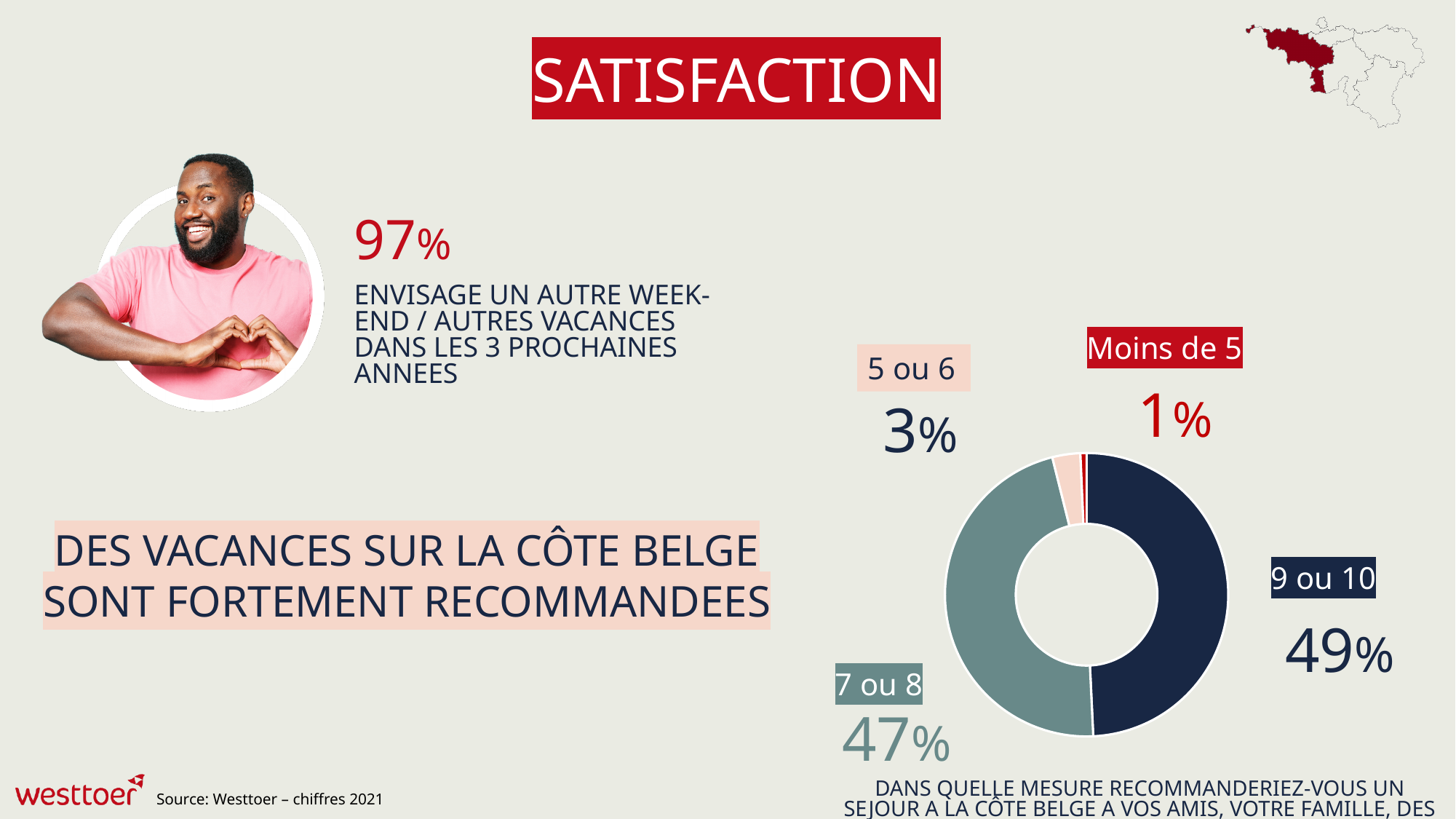
What percentage of respondents gave a score of 7 ou 8? 47% What percentage of respondents gave a score of 9 ou 10? 49% What percentage of respondents gave a score of 5 ou 6? 3% What percentage of respondents gave a score of Moins de 5? 1% Which is larger, the share for 7 ou 8 or the share for 5 ou 6? 7 ou 8 How many categories does the donut chart show? 4 How many percentage points separate the 9 ou 10 and 7 ou 8 categories? 2 Which category has the largest share of the donut chart? 9 ou 10 Which category has the smallest share of the donut chart? Moins de 5 What kind of chart is shown on the right of the slide? donut (pie) chart What is the combined share of the 9 ou 10 and 7 ou 8 categories? 96% What colour is the Moins de 5 segment of the donut chart? red